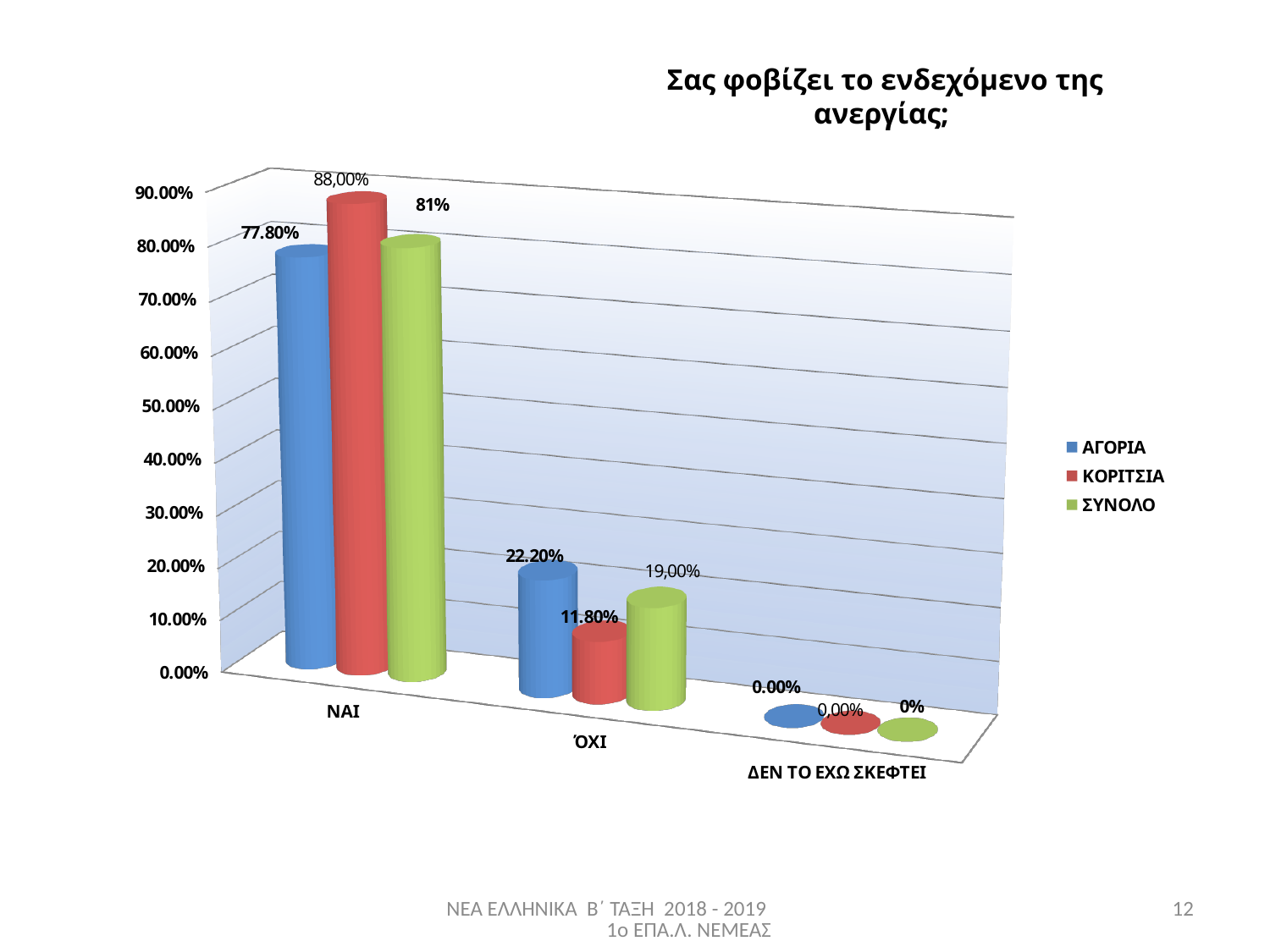
What kind of chart is shown on the slide? Bar chart How many series does the legend list? 3 What is the value for ΚΟΡΙΤΣΙΑ in the ΝΑΙ category? 88,00% What is the value for ΣΥΝΟΛΟ in the ΌΧΙ category? 19,00% Which series has the highest value in the ΝΑΙ category? ΚΟΡΙΤΣΙΑ Which series has the lowest value in the ΌΧΙ category? ΚΟΡΙΤΣΙΑ What is the value for ΚΟΡΙΤΣΙΑ in the ΌΧΙ category? 11.80% What is the title of the chart? Σας φοβίζει το ενδεχόμενο της ανεργίας; How many categories are shown on the x axis? 3 What is the value for ΑΓΟΡΙΑ in the ΝΑΙ category? 77.80% What is the difference between the ΑΓΟΡΙΑ and ΚΟΡΙΤΣΙΑ values in the ΌΧΙ category? 10.40% Which is larger: the ΑΓΟΡΙΑ value for ΝΑΙ or the ΣΥΝΟΛΟ value for ΝΑΙ? ΣΥΝΟΛΟ